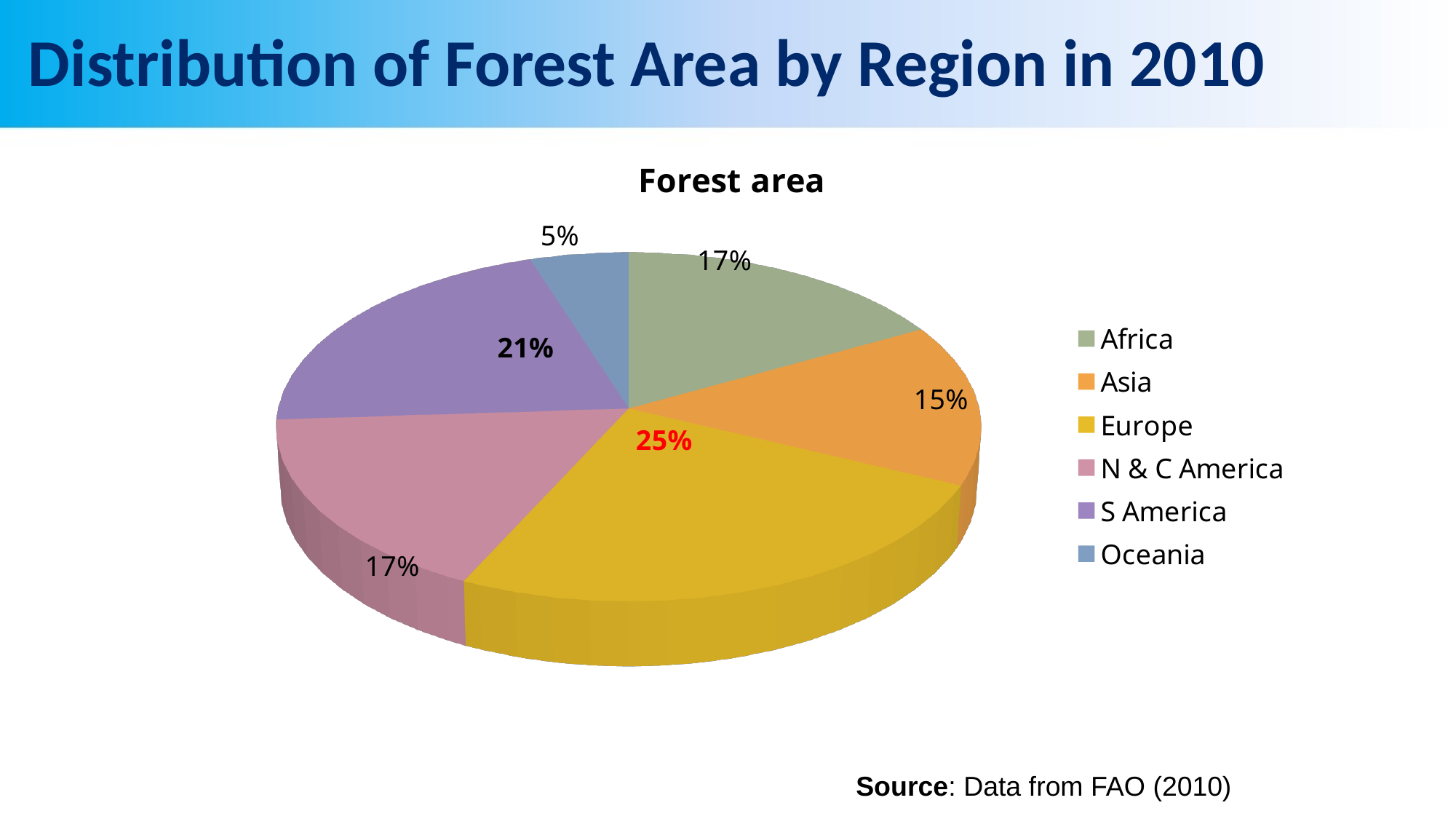
What share of forest area does Oceania have? 5% Which region has the smallest share of forest area? Oceania Which has a larger share of forest area, S America or Africa? S America What is the difference between Europe's share and Asia's share? 10% How many regions are shown in the pie chart? 6 Which region has the largest share of forest area? Europe What kind of chart is shown on the slide? Pie chart What share of forest area does Europe have? 25% Which region's slice is coloured yellow? Europe What share of forest area does Asia have? 15% What share of forest area does S America have? 21% What is the title of the chart? Forest area